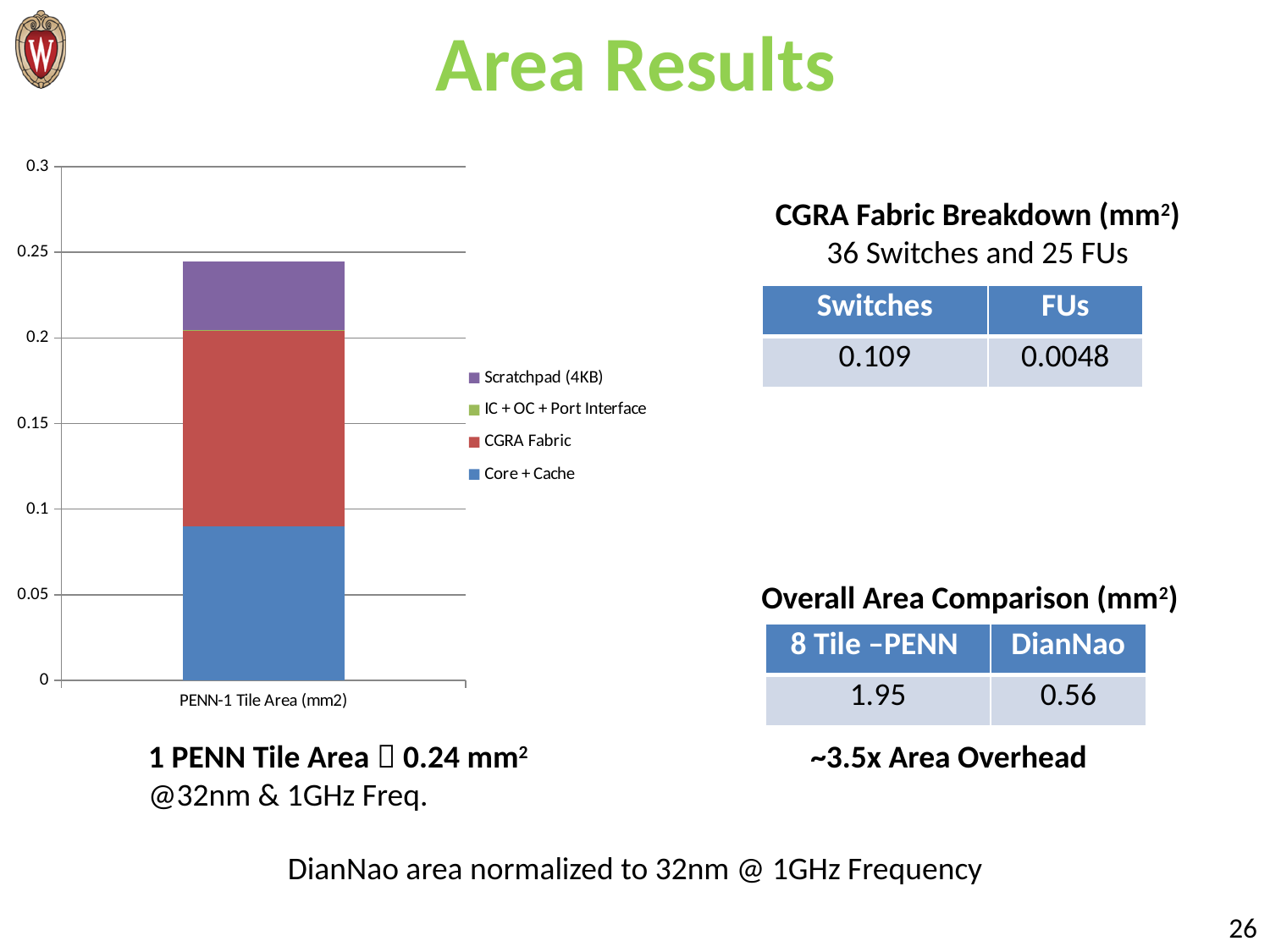
Which series in the stacked bar occupies the smallest segment? IC + OC + Port Interface How many series does the chart's legend list? 4 Is the Core + Cache segment of the bar greater or less than 0.1? less What is the label of the single category on the x axis of the chart? PENN-1 Tile Area (mm2) What colour is the CGRA Fabric series in the chart? red Which segment is larger in the bar, CGRA Fabric or Scratchpad (4KB)? CGRA Fabric Is the Scratchpad (4KB) segment of the bar greater or less than 0.05? less Which series in the stacked bar occupies the largest segment? CGRA Fabric What kind of chart is shown on the slide? stacked bar chart Is the total height of the stacked bar greater or less than 0.2? greater Which segment is larger in the bar, Core + Cache or Scratchpad (4KB)? Core + Cache How many categories are plotted on the x axis of the chart? 1